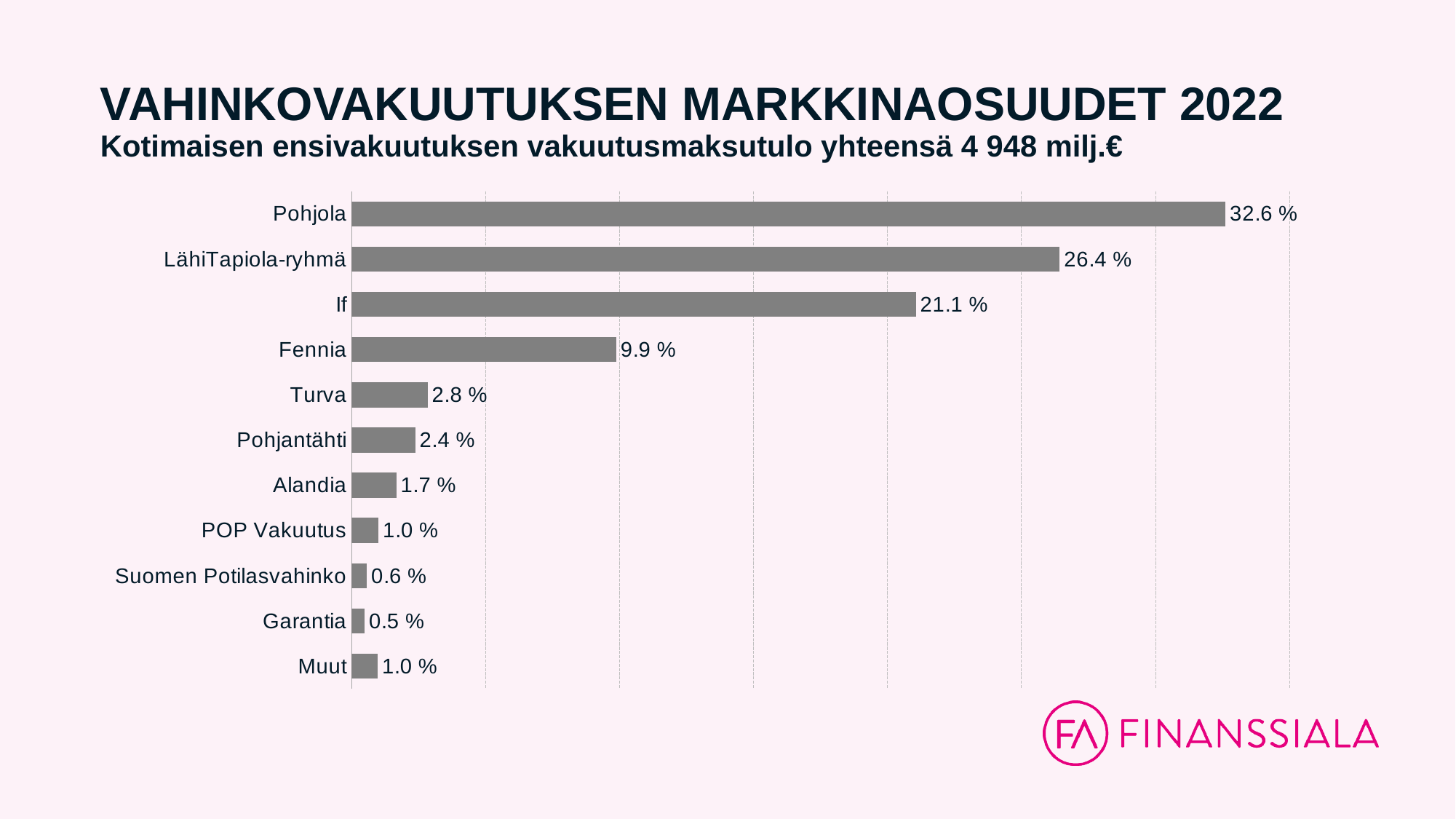
How many categories are shown in the chart? 11 Which has a larger market share, Turva or Pohjantähti? Turva What kind of chart is shown on the slide? Bar chart What is the difference in market share between Pohjola and LähiTapiola-ryhmä? 6.2 % What is the market share shown for Pohjola? 32.6 % What is the market share shown for Suomen Potilasvahinko? 0.6 % What is the market share shown for Fennia? 9.9 % What is the difference in market share between If and Fennia? 11.2 % Which company has the smallest market share? Garantia Which company has the largest market share? Pohjola What is the market share shown for Alandia? 1.7 % What is the title of the chart on the slide? VAHINKOVAKUUTUKSEN MARKKINAOSUUDET 2022